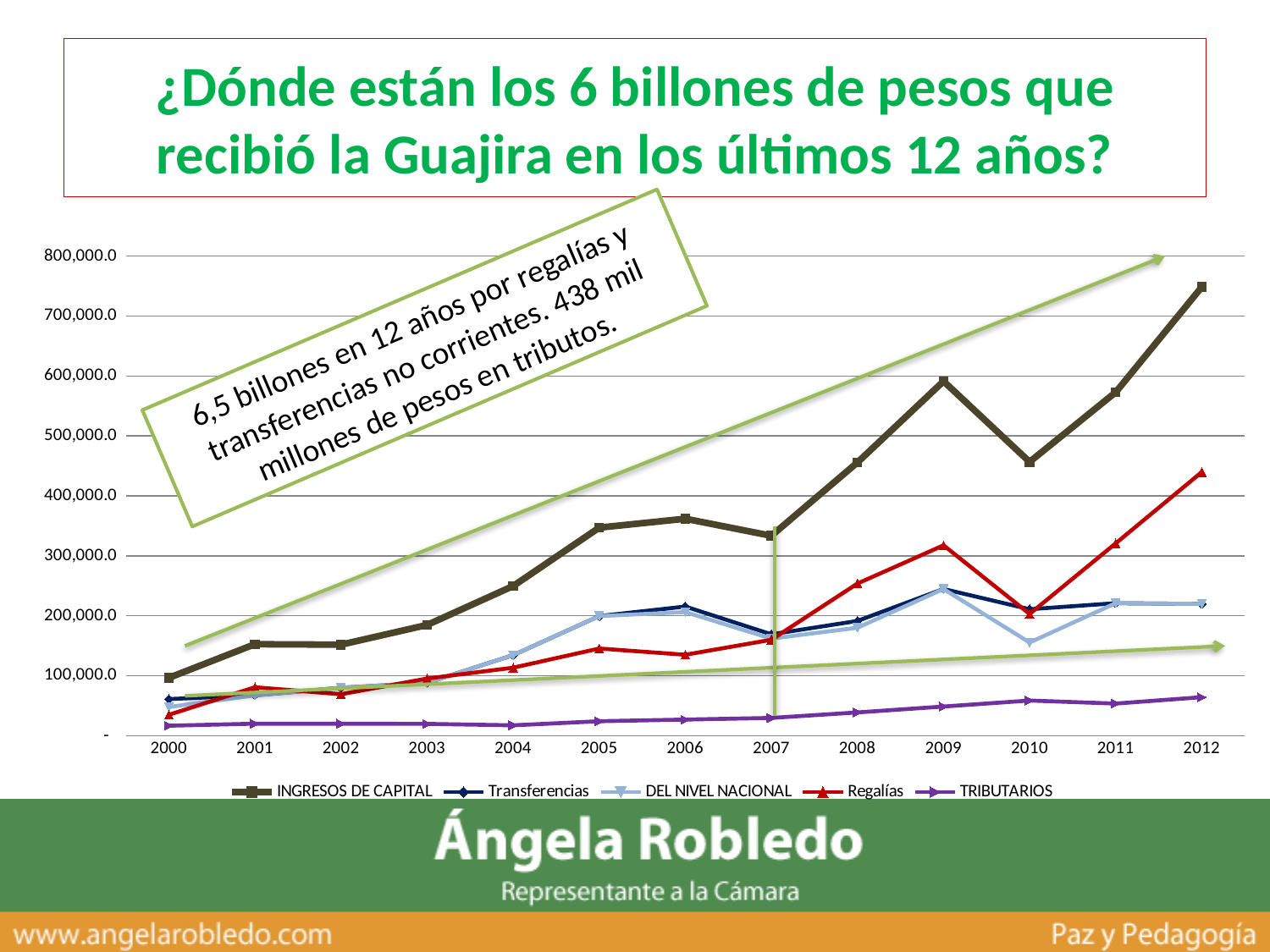
For the Regalías series, which year has the larger value: 2009 or 2010? 2009 How many years are plotted along the x axis of the chart? 13 In which year does the INGRESOS DE CAPITAL series reach its highest value? 2012 Overall, does the INGRESOS DE CAPITAL series rise or fall from 2000 to 2012? rise How many series does the chart's legend list? 5 Is the value for Regalías in 2012 greater or less than 400,000.0? greater Is the value for INGRESOS DE CAPITAL in 2012 greater or less than 700,000.0? greater What kind of chart is shown on the slide? line chart Is the value for INGRESOS DE CAPITAL in 2000 greater or less than 200,000.0? less In 2009, which is larger: INGRESOS DE CAPITAL or Regalías? INGRESOS DE CAPITAL Which series has the lowest value in 2012? TRIBUTARIOS